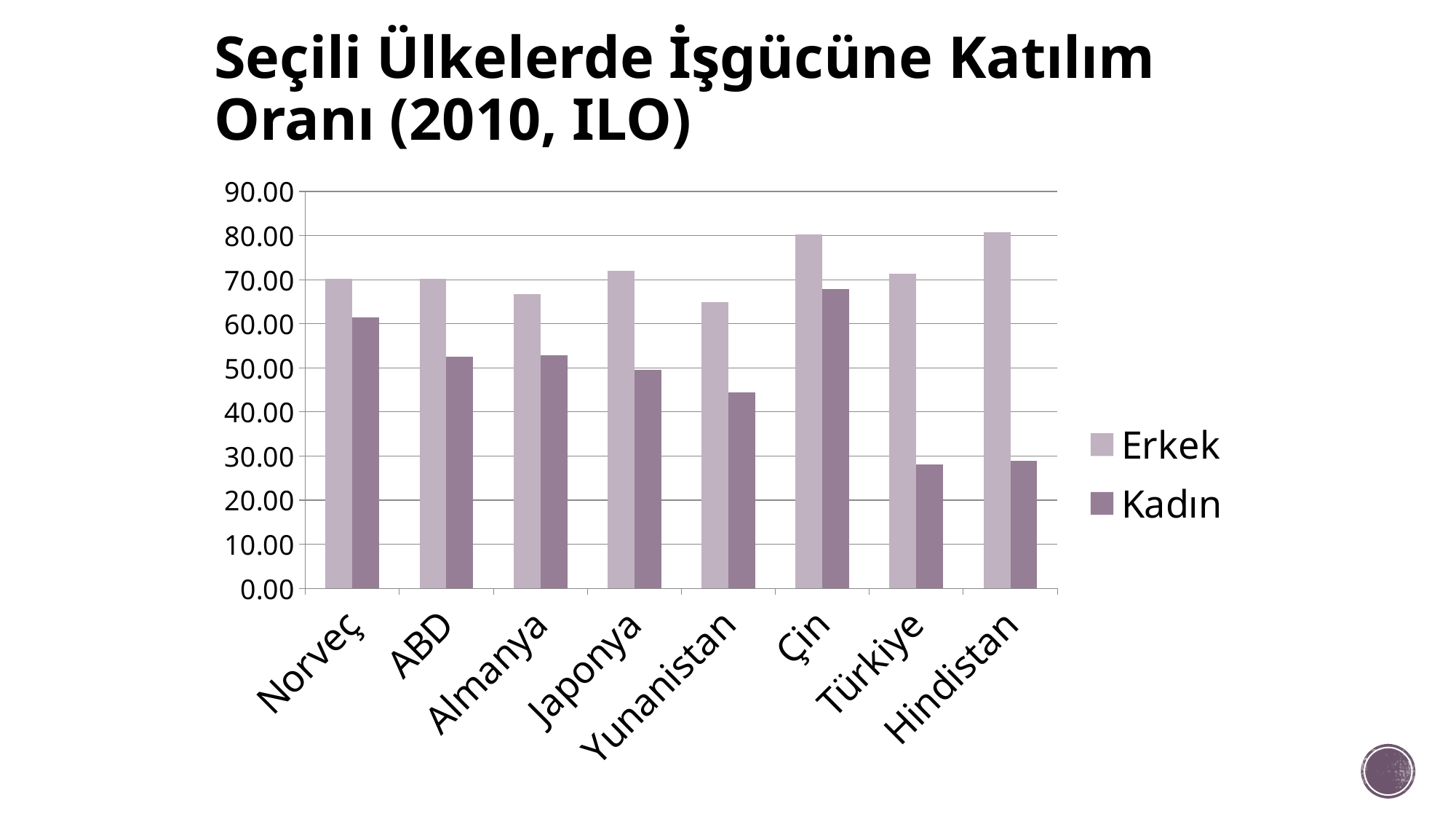
Is the Kadın value for Türkiye greater or less than 30? less Is the Kadın value for Yunanistan greater or less than 40? greater Which is larger, the Erkek value for Japonya or the Erkek value for Yunanistan? Japonya Is the Erkek value for Almanya greater or less than 70? less How many countries are shown on the x axis of the chart? 8 Which is larger, the Kadın value for Çin or the Kadın value for Türkiye? Çin What kind of chart is shown on the slide? bar chart Which is larger, the Kadın value for Norveç or the Kadın value for ABD? Norveç Which country has the highest Kadın value? Çin What are the two series named in the legend? Erkek and Kadın How many series does the legend list? 2